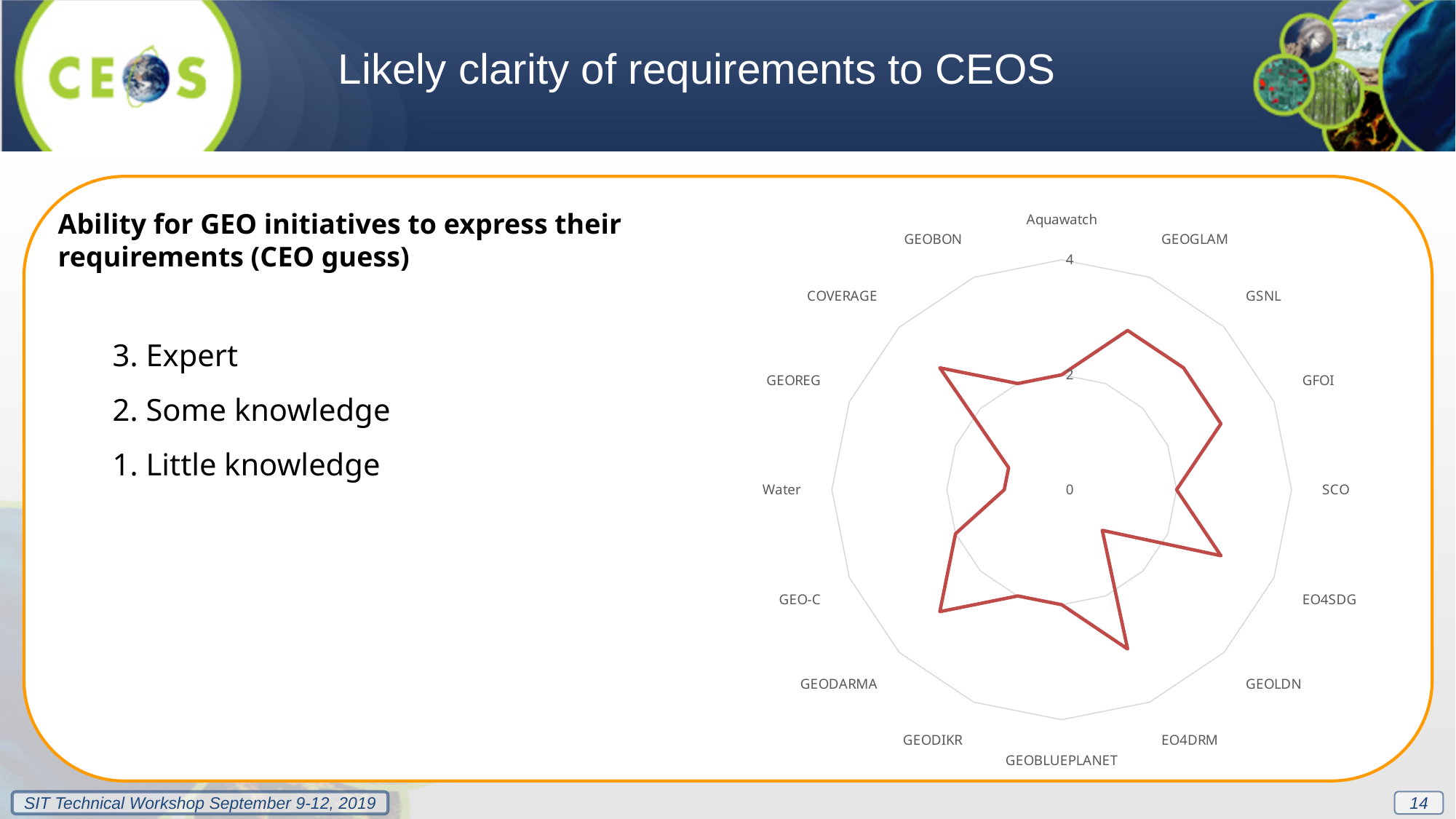
Is the value for Water greater or less than 2? less Is the value for GSNL greater or less than 4? less Is the value for GEODARMA greater or less than 2? greater What kind of chart is shown on the slide? Radar chart Which has the larger value, GFOI or GEOLDN? GFOI What is the highest value marked on the radar chart's axis? 4 How many GEO initiatives (categories) are plotted on the radar chart? 16 Which has the larger value, COVERAGE or Water? COVERAGE